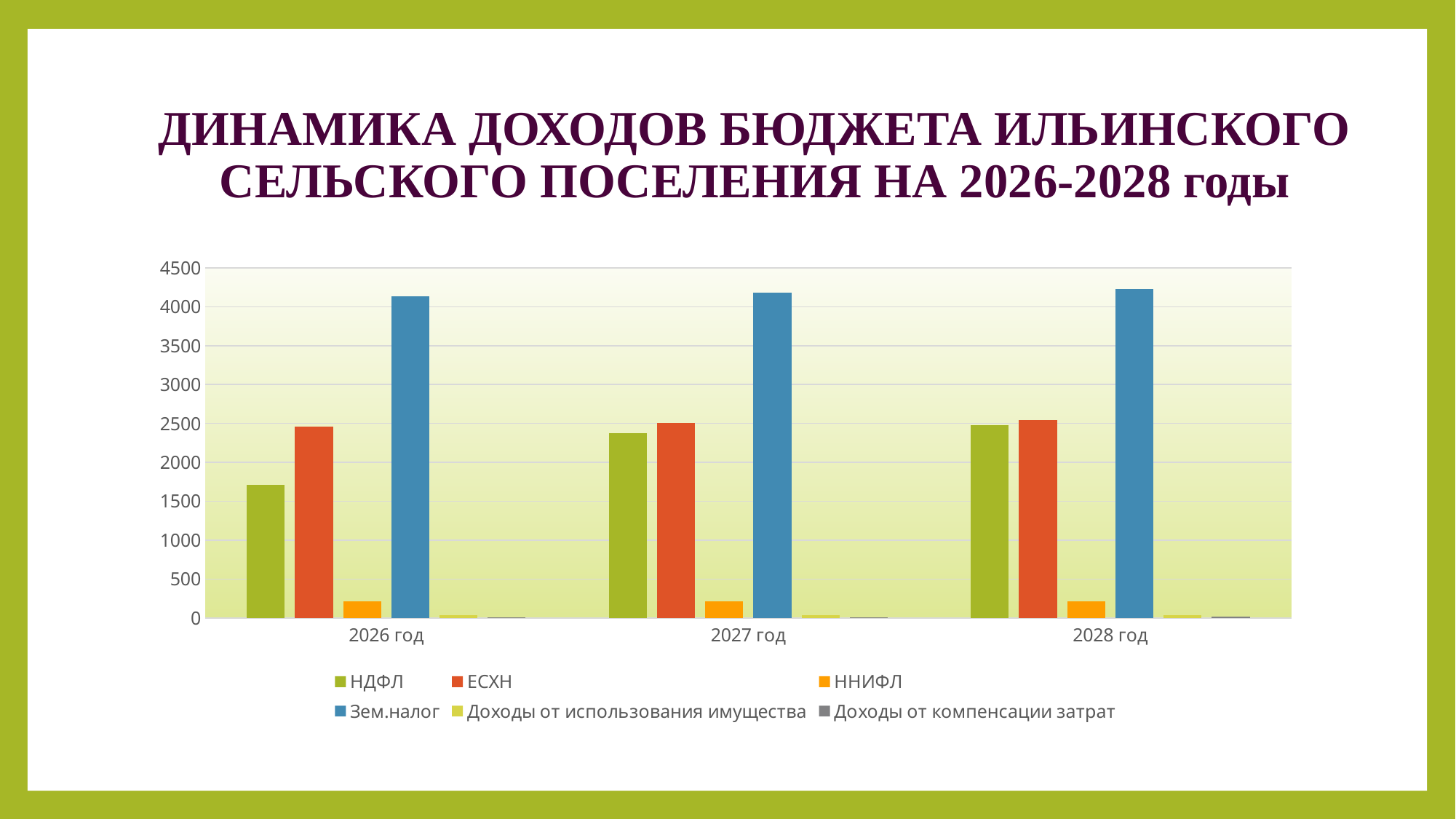
What colour represents Зем.налог in the chart? blue What kind of chart is shown on the slide? bar chart Which series has the lowest value for 2026 год? Доходы от компенсации затрат Is the value for Зем.налог in 2027 год greater or less than 4000? greater Is the value for ННИФЛ in 2028 год greater or less than 500? less Does the value for НДФЛ rise or fall from 2026 год to 2028 год? rises Is the value for НДФЛ in 2026 год greater or less than 2000? less In 2026 год, which is larger: НДФЛ or ЕСХН? ЕСХН How many series does the legend list? 6 How many year categories are shown on the x axis? 3 What is the title of the slide? ДИНАМИКА ДОХОДОВ БЮДЖЕТА ИЛЬИНСКОГО СЕЛЬСКОГО ПОСЕЛЕНИЯ НА 2026-2028 годы Which series has the highest value for 2026 год? Зем.налог